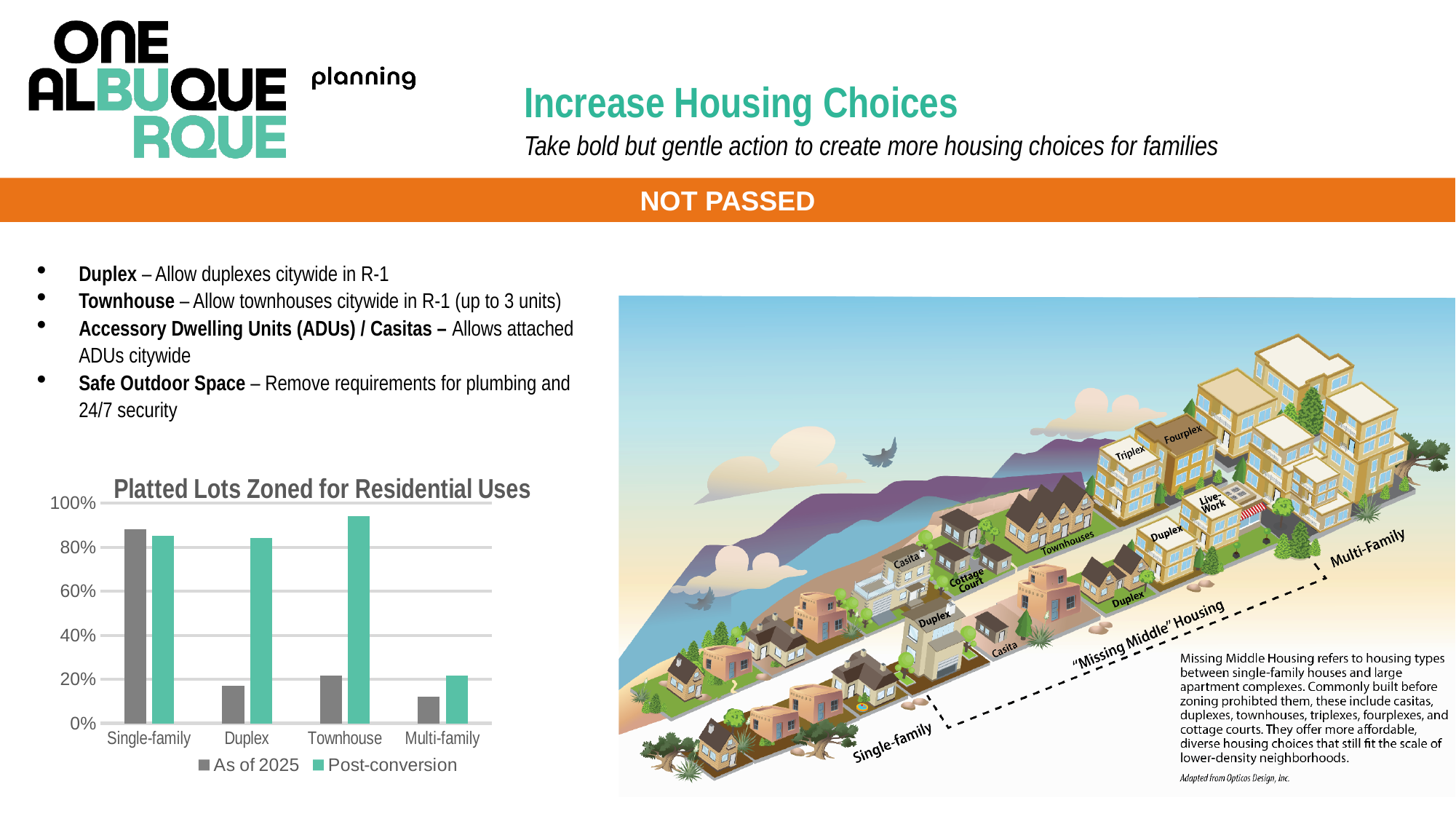
What is the title of the chart? Platted Lots Zoned for Residential Uses Which category has the highest Post-conversion value? Townhouse Which category has the lowest Post-conversion value? Multi-family Is the As of 2025 value for Duplex greater or less than 20%? less How many series does the chart legend list? 2 For Duplex, which is larger: the As of 2025 value or the Post-conversion value? Post-conversion How many categories are shown on the x axis of the chart? 4 Is the Post-conversion value for Townhouse greater or less than 80%? greater What kind of chart is shown on the slide? bar chart Which category has the lowest As of 2025 value? Multi-family Which series is shown in gray in the chart? As of 2025 Which category has the highest As of 2025 value? Single-family